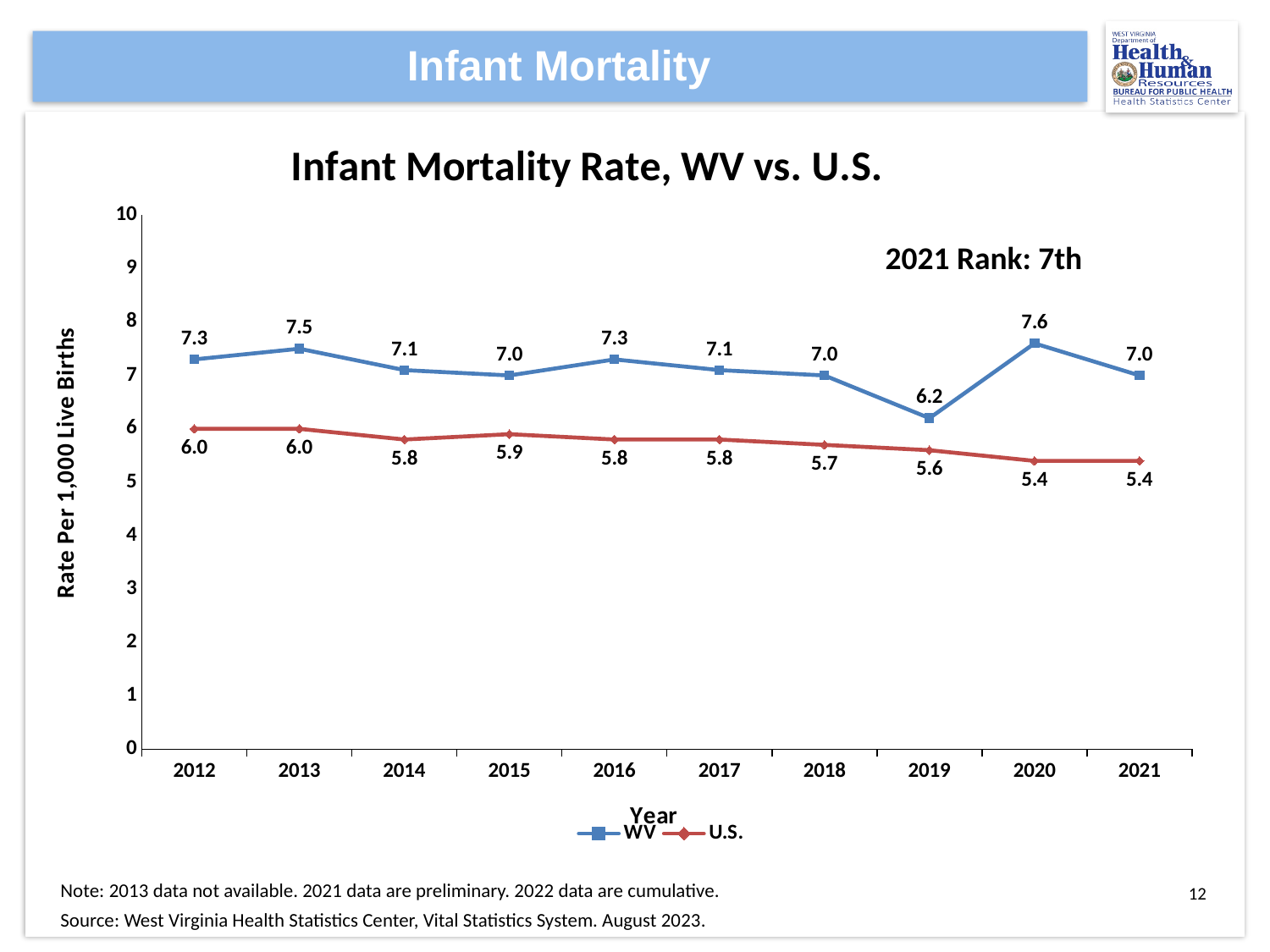
What is the WV infant mortality rate in 2019? 6.2 In which year is the WV infant mortality rate lowest? 2019 In which year is the WV infant mortality rate highest? 2020 What is the title of the chart? Infant Mortality Rate, WV vs. U.S. Which is higher in 2016, the WV rate or the U.S. rate? WV How many series does the legend list? 2 Does the U.S. infant mortality rate generally rise or fall from 2012 to 2021? Fall What is the U.S. infant mortality rate in 2018? 5.7 What kind of chart is shown on the slide? Line chart What is the difference between the WV and U.S. infant mortality rates in 2020? 2.2 How many years are shown on the x axis? 10 What is the WV infant mortality rate in 2013? 7.5